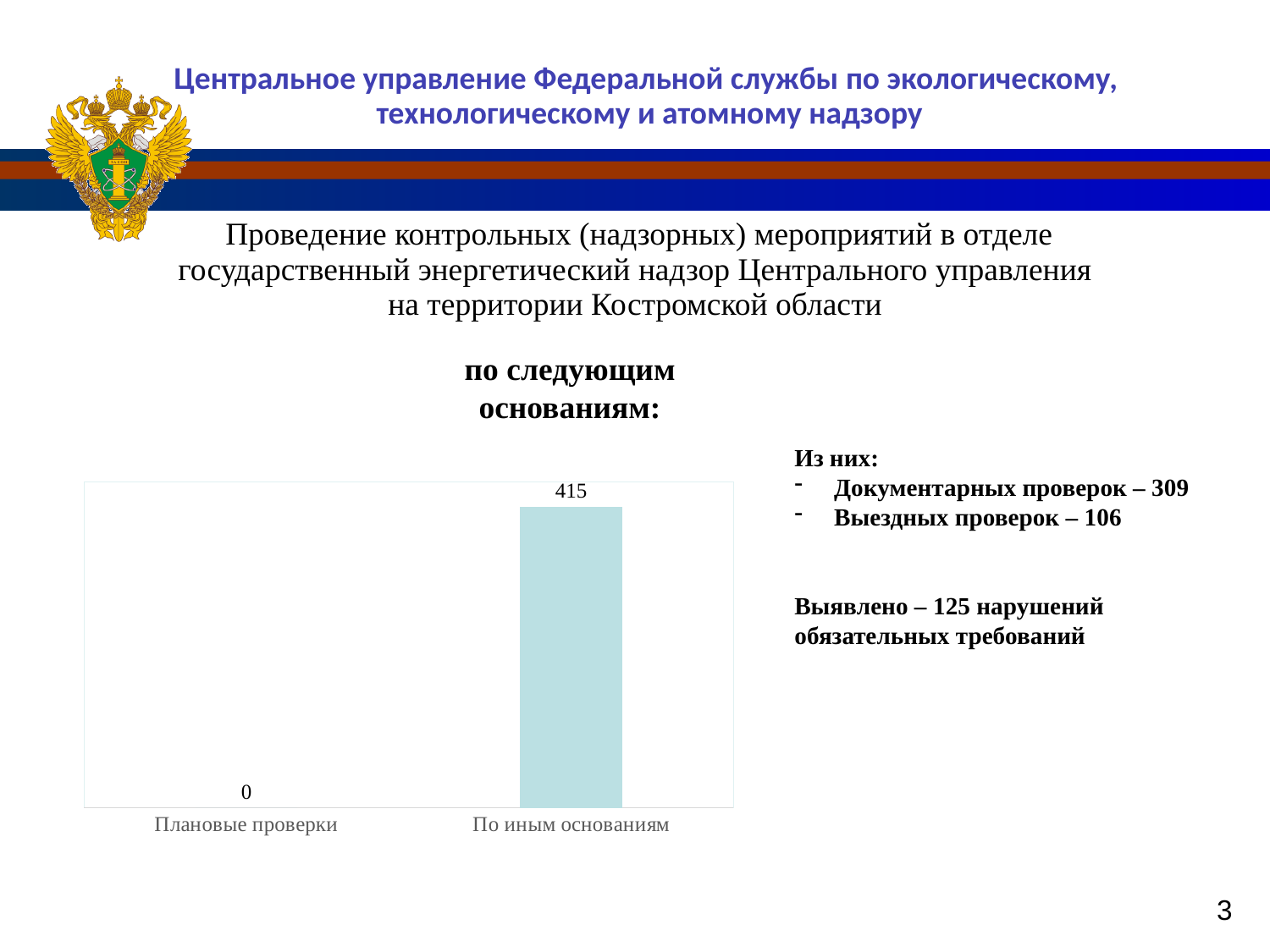
What colour is the bar for По иным основаниям? light blue Which category has the highest value? По иным основаниям What is the value for Плановые проверки? 0 What is the title printed above the chart? по следующим основаниям: What is the total of the two plotted values? 415 Which category has the lowest value? Плановые проверки What is the difference between the values for По иным основаниям and Плановые проверки? 415 What kind of chart is shown on the slide? bar chart What is the value for По иным основаниям? 415 How many categories are shown on the chart? 2 Which is larger, the value for Плановые проверки or the value for По иным основаниям? По иным основаниям Do the values rise or fall from left to right along the x axis? rise